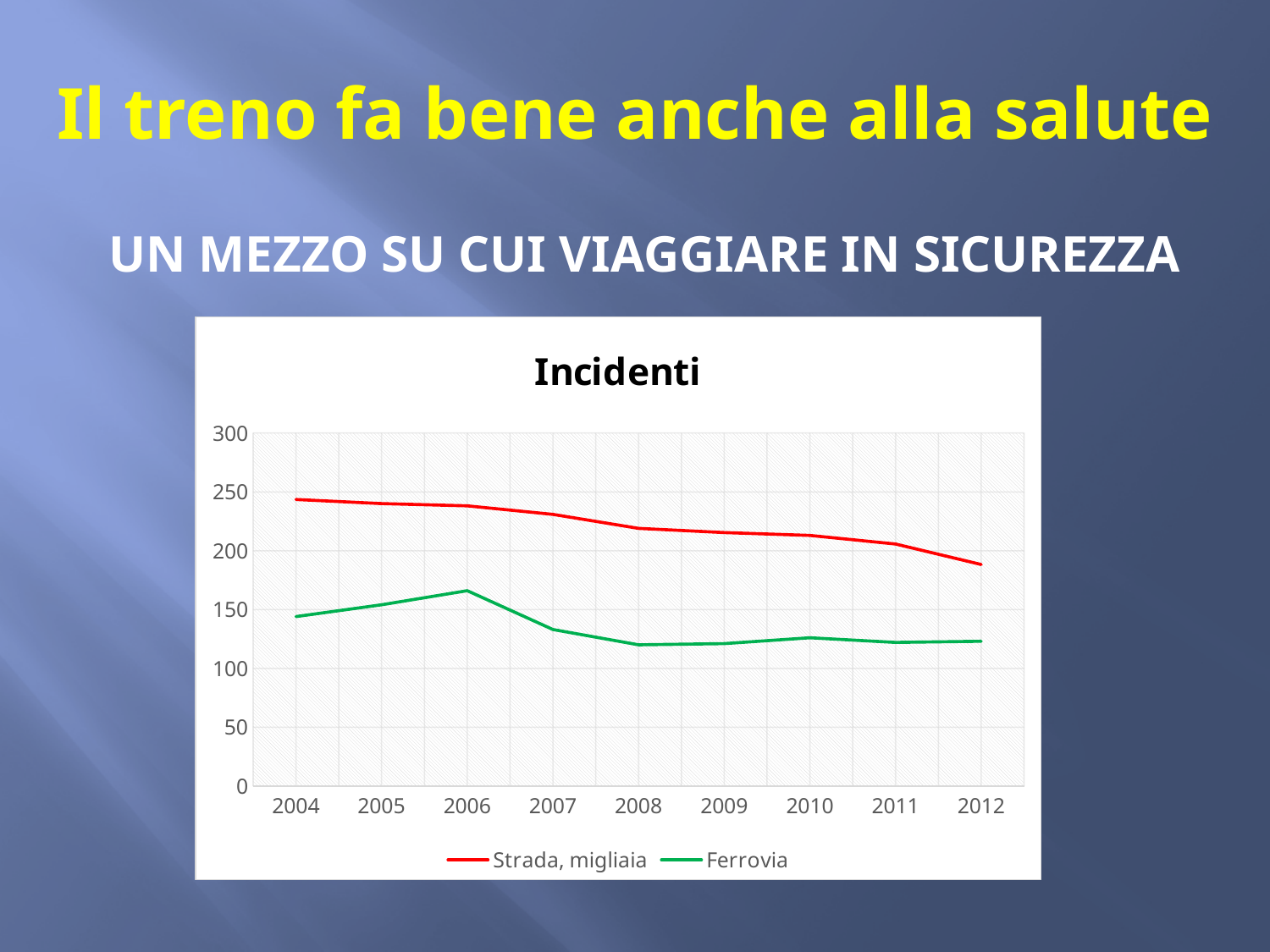
In 2004, which series has the larger value, Strada, migliaia or Ferrovia? Strada, migliaia What kind of chart is shown on the slide? line chart What is the title of the chart? Incidenti How many years are shown on the x axis? 9 In which year does the Strada, migliaia series reach its lowest value? 2012 In which year does the Ferrovia series reach its highest value? 2006 Is the value for Ferrovia in 2008 greater or less than 150? less Is the value for Ferrovia in 2006 greater or less than 150? greater Does the Strada, migliaia series rise or fall from 2004 to 2012? fall Is the value for Strada, migliaia in 2012 greater or less than 200? less How many series does the legend list? 2 In which year does the Strada, migliaia series reach its highest value? 2004